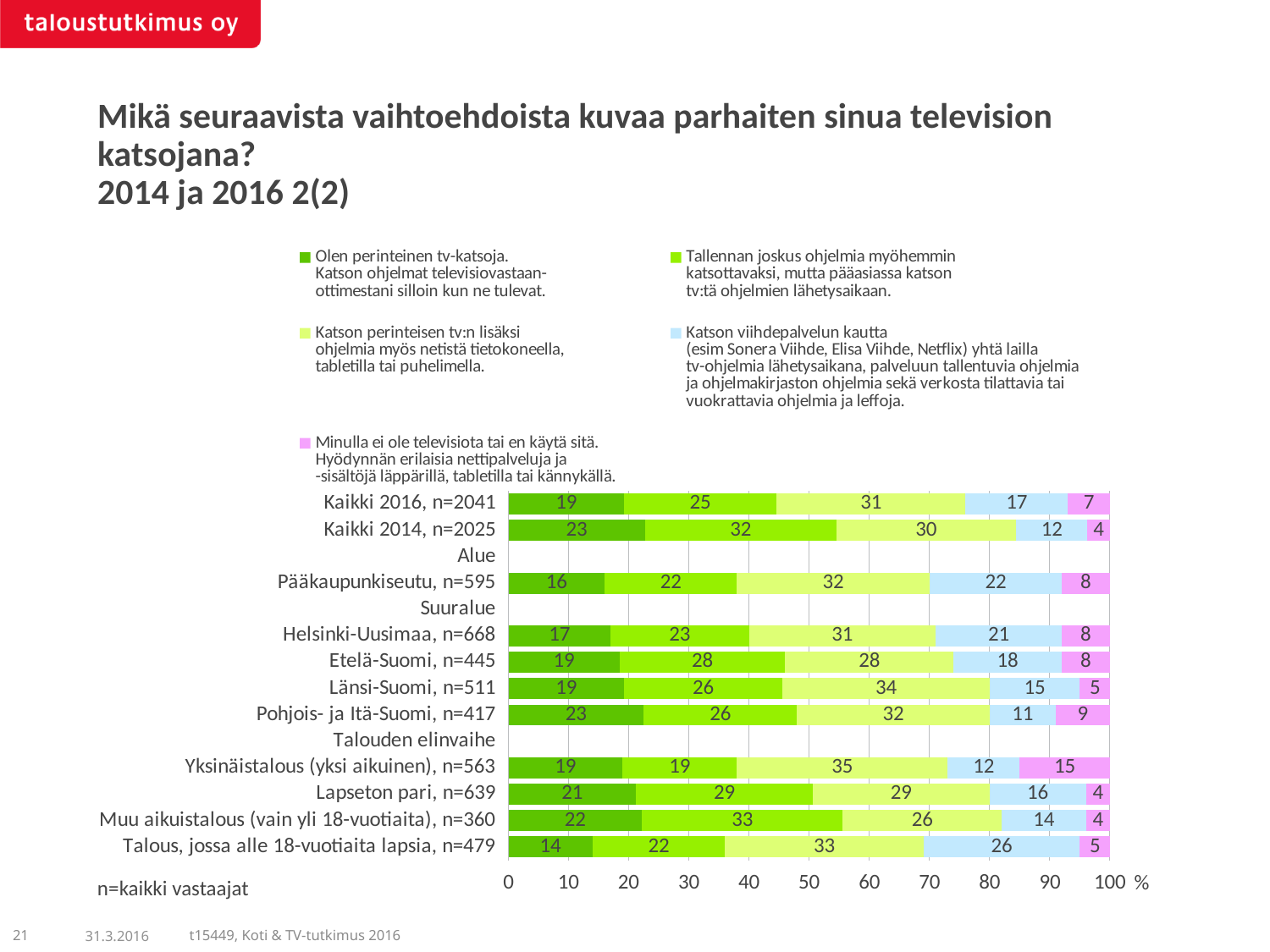
What is the maximum value shown on the x axis? 100 % How many series does the legend list? 5 What is the value of the pink segment (Minulla ei ole televisiota tai en käytä sitä) for Kaikki 2014, n=2025? 4 Which category has the highest value for the pink segment (Minulla ei ole televisiota tai en käytä sitä)? Yksinäistalous (yksi aikuinen), n=563 How many categories have bars plotted in the chart? 12 Which category has the lowest value for the dark green segment (Olen perinteinen tv-katsoja)? Talous, jossa alle 18-vuotiaita lapsia, n=479 What is the value of the pale green segment (Katson perinteisen tv:n lisäksi ohjelmia myös netistä) for Länsi-Suomi, n=511? 34 What is the value of the dark green segment (Olen perinteinen tv-katsoja) for Kaikki 2016, n=2041? 19 What kind of chart is shown on the slide? Stacked bar chart Which has the larger light blue segment (Katson viihdepalvelun kautta): Talous, jossa alle 18-vuotiaita lapsia, n=479 or Pohjois- ja Itä-Suomi, n=417? Talous, jossa alle 18-vuotiaita lapsia, n=479 What is the value of the light blue segment (Katson viihdepalvelun kautta) for Pääkaupunkiseutu, n=595? 22 By how much does the dark green segment (Olen perinteinen tv-katsoja) for Kaikki 2014 exceed that for Kaikki 2016? 4